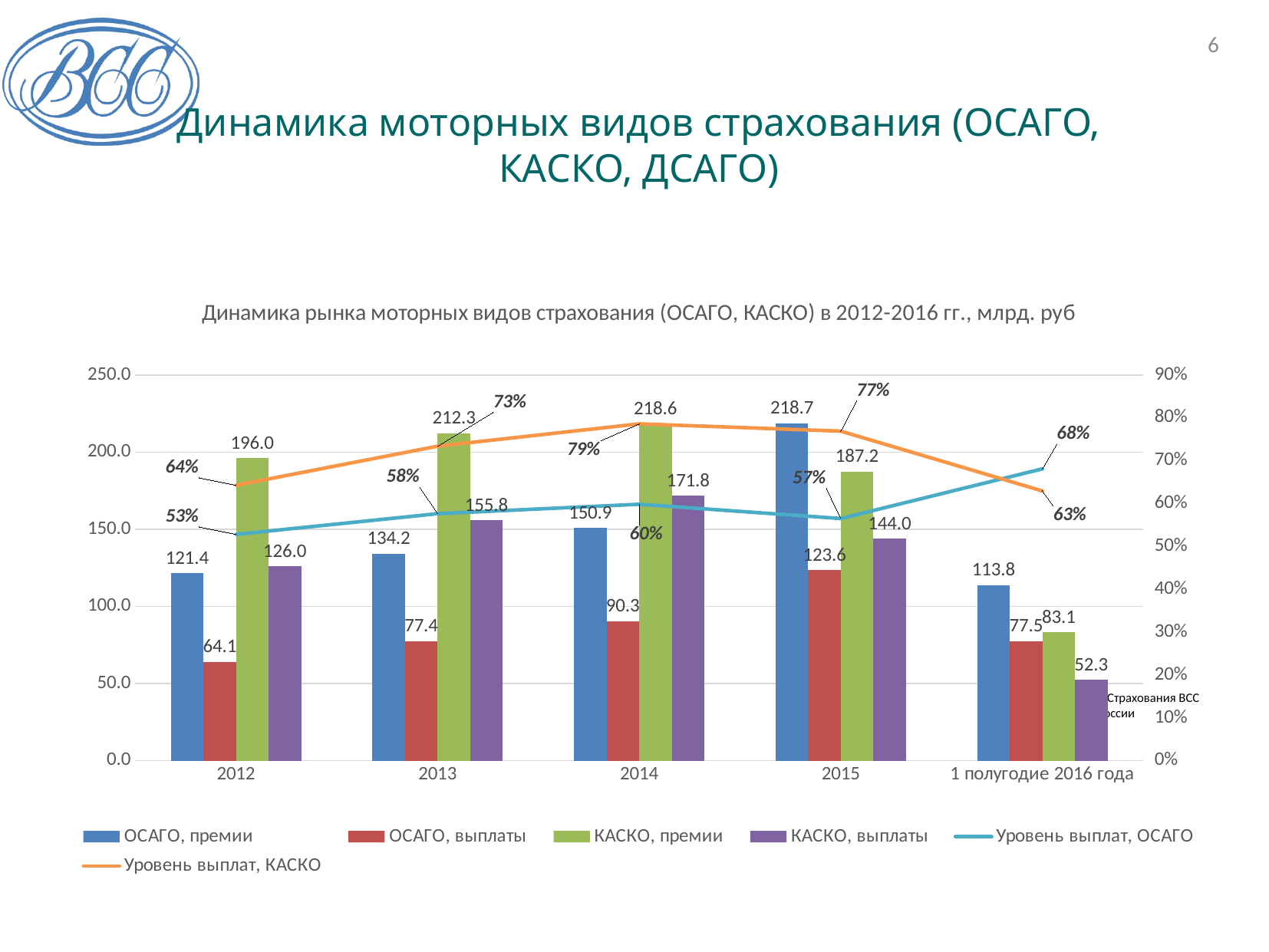
By how much did КАСКО, премии increase from 2012 to 2013? 16.3 How many series does the legend list? 6 How many periods are shown on the x axis? 5 In which period is КАСКО, премии the highest? 2014 What is the difference between ОСАГО, премии and ОСАГО, выплаты in 2014? 60.6 What is the Уровень выплат, ОСАГО for 1 полугодие 2016 года? 68% What is the value of ОСАГО, премии for 2015? 218.7 What kind of chart is this? Bar chart combined with line chart What is the value of КАСКО, премии for 2012? 196.0 What is the Уровень выплат, КАСКО for 2014? 79% In 2015, which is larger: ОСАГО, премии or КАСКО, премии? ОСАГО, премии In which period is КАСКО, выплаты the lowest? 1 полугодие 2016 года